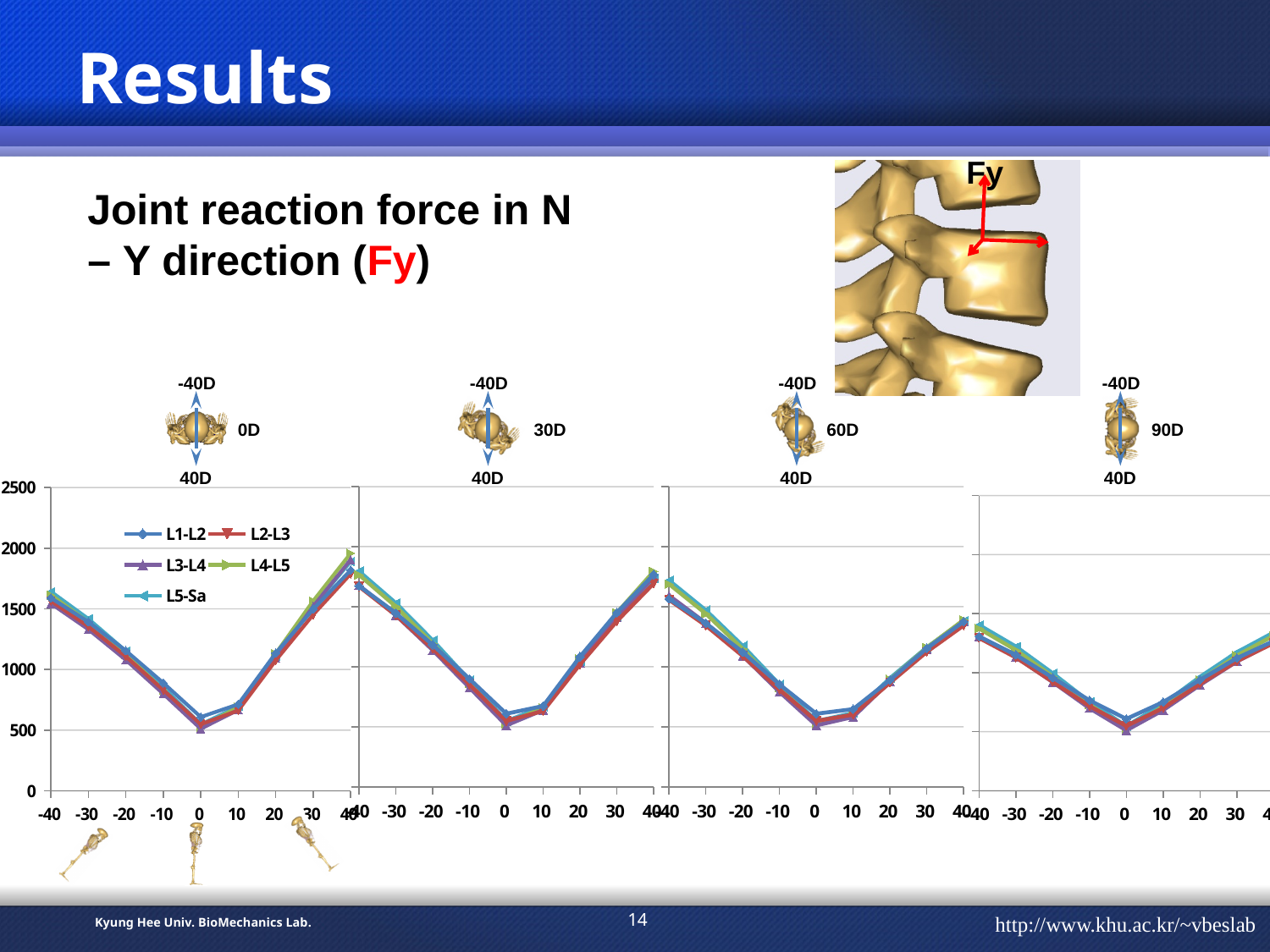
Which series in the legend is drawn in red? L2-L3 What kind of chart is used to show the joint reaction force Fy on this slide? line chart What is the maximum value shown on the y axis of the 0D chart? 2500 In the 90D chart, is the value for L1-L2 at x = 40 greater or less than 1500? less In the 0D chart, is the value for L1-L2 at x = 0 greater or less than 1000? less In the 60D chart, is the value for L4-L5 at x = 40 greater or less than 1500? less How many charts (trunk rotation conditions) are shown on the slide? 4 In the 30D chart, do the values for L2-L3 rise or fall as x goes from -40 to 0? fall In the 0D chart, how many x-axis tick positions are plotted from -40 to 40? 9 How many series does the legend of the 0D chart list? 5 In the 90D chart, do the values for L1-L2 rise or fall as x goes from 0 to 40? rise